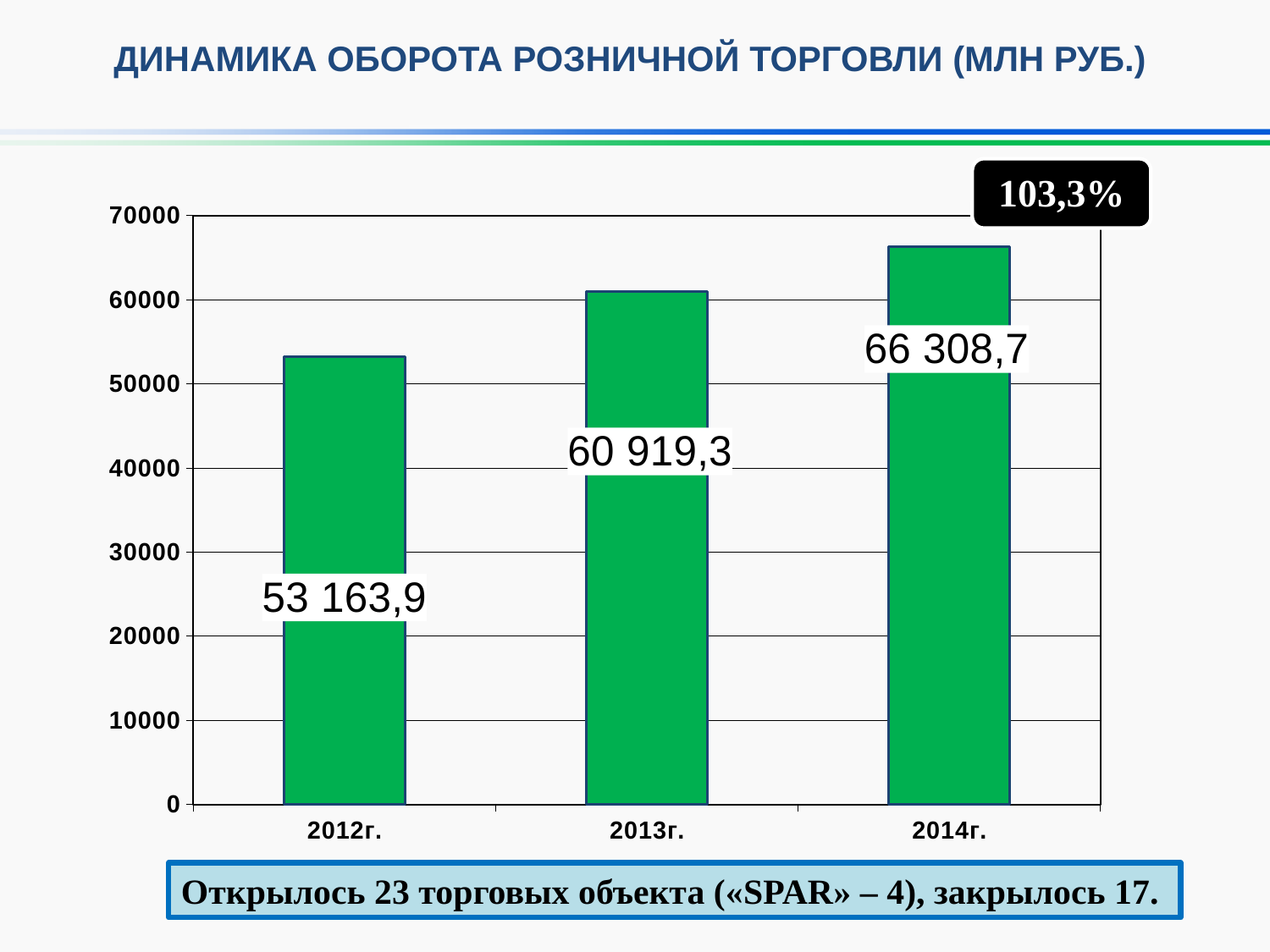
Which is larger, the value for 2012г. or the value for 2013г.? 2013г. What is the retail trade turnover value shown for 2013г.? 60 919,3 What is the difference between the 2013г. and 2012г. values? 7 755,4 Is the value for 2014г. greater or less than 60000? greater How many years are shown on the chart? 3 Which year has the highest retail trade turnover? 2014г. What is the difference between the 2014г. and 2013г. values? 5 389,4 Which year has the lowest retail trade turnover? 2012г. What is the retail trade turnover value shown for 2014г.? 66 308,7 What kind of chart is shown on the slide? bar chart Do the values rise or fall from 2012г. to 2014г.? rise What is the retail trade turnover value shown for 2012г.? 53 163,9